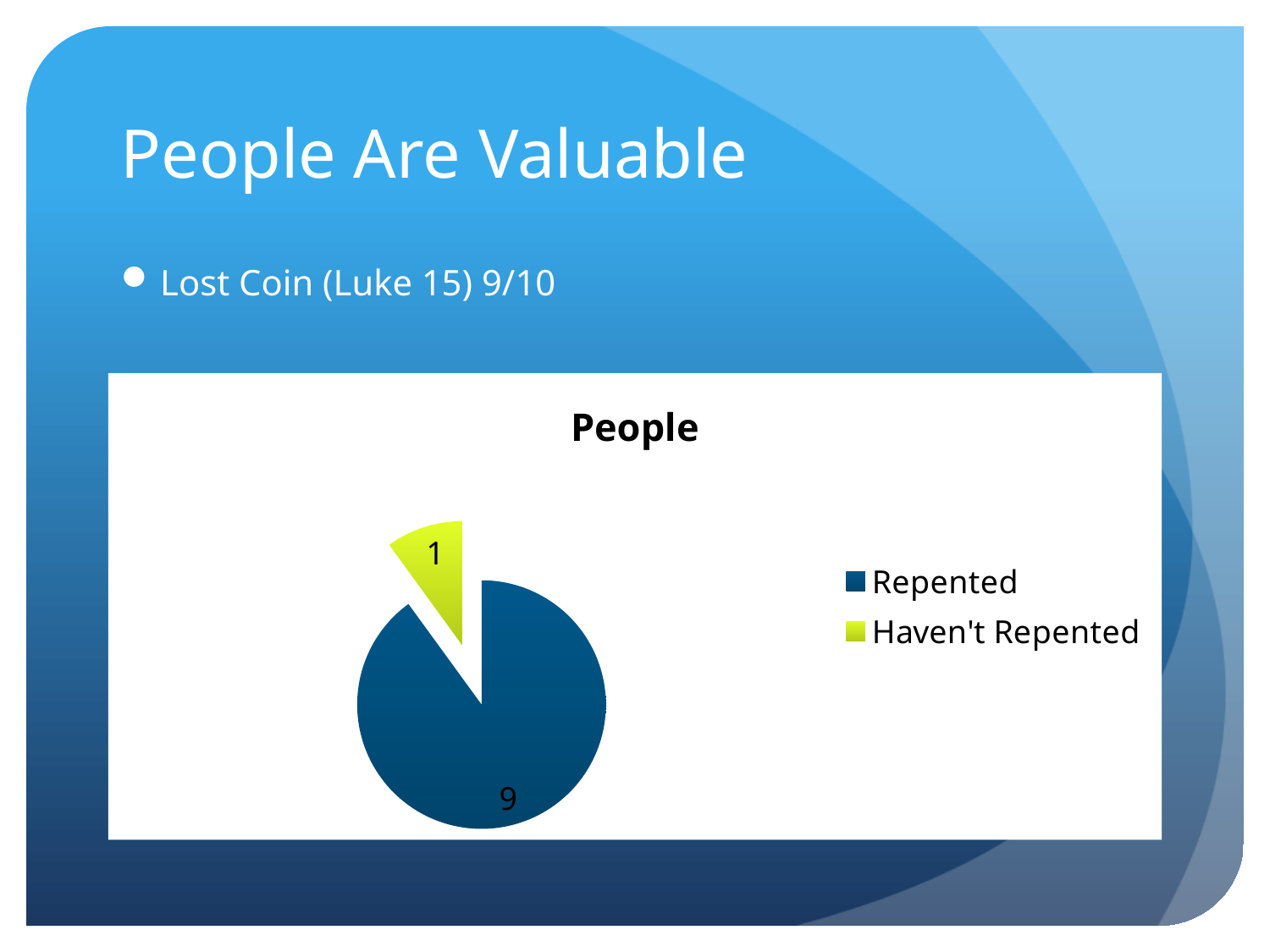
What is the title of the chart? People Which is larger, Repented or Haven't Repented? Repented What share of the pie does the Repented slice represent? 90% Which category has the smallest slice of the pie? Haven't Repented How many entries does the legend list? 2 Which category has the largest slice of the pie? Repented What colour is the Haven't Repented slice? yellow-green What is the difference between the values for Repented and Haven't Repented? 8 What is the value for Haven't Repented? 1 What type of chart is shown on the slide? pie chart What is the value for Repented? 9 How many slices does the pie chart have? 2